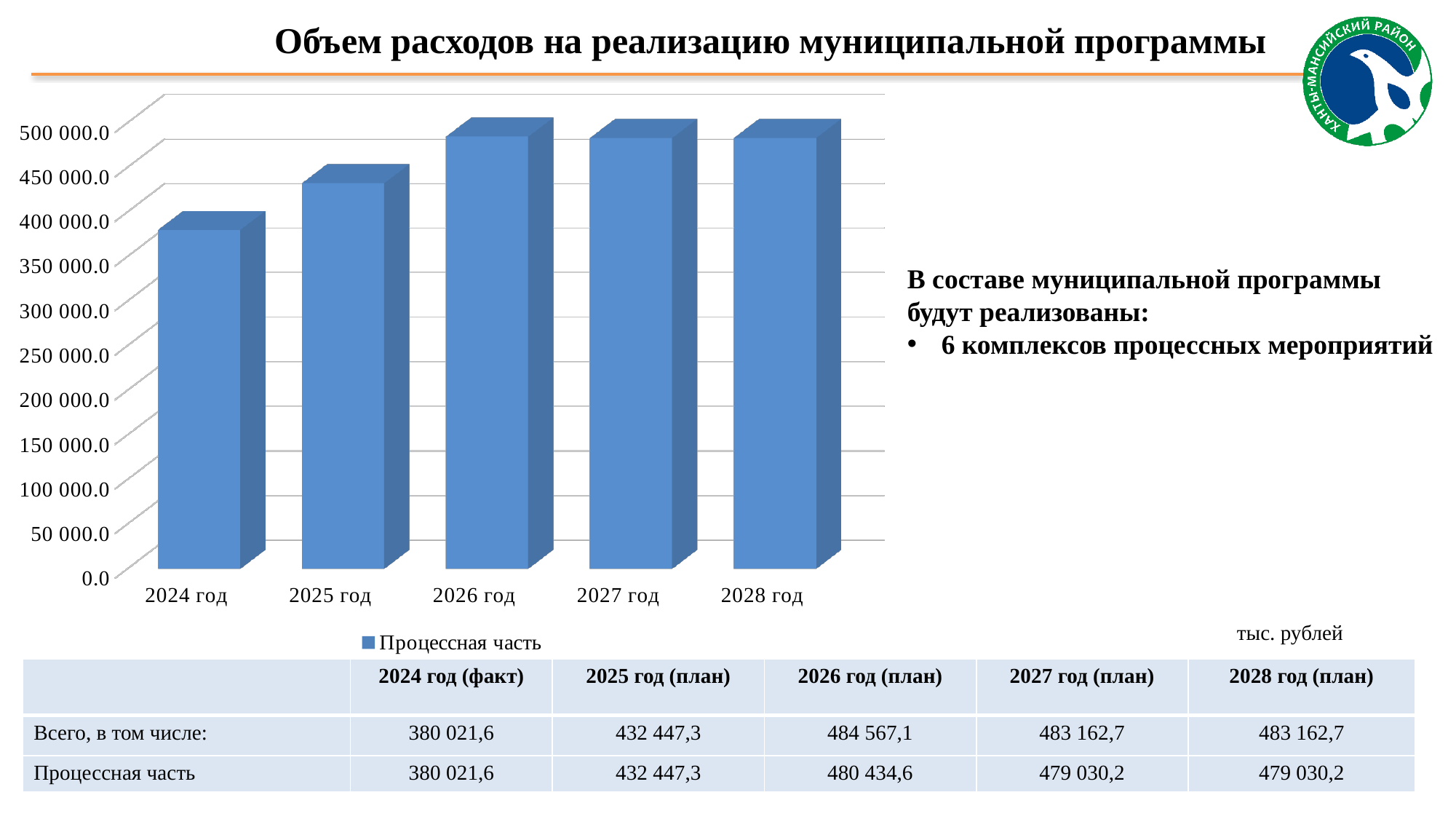
Do the values rise or fall from 2024 год to 2026 год? rise What kind of chart is shown on the slide? bar chart Which bar is taller, 2024 год or 2025 год? 2025 год Which year has the lowest bar in the chart? 2024 год Is the value for 2025 год greater or less than 450 000.0? less How many series does the chart legend list? 1 Is the value for 2024 год greater or less than 350 000.0? greater What is the name of the series shown in the chart legend? Процессная часть What is the title of the chart on the slide? Объем расходов на реализацию муниципальной программы Is the value for 2024 год greater or less than 400 000.0? less How many years (categories) are shown on the x axis of the chart? 5